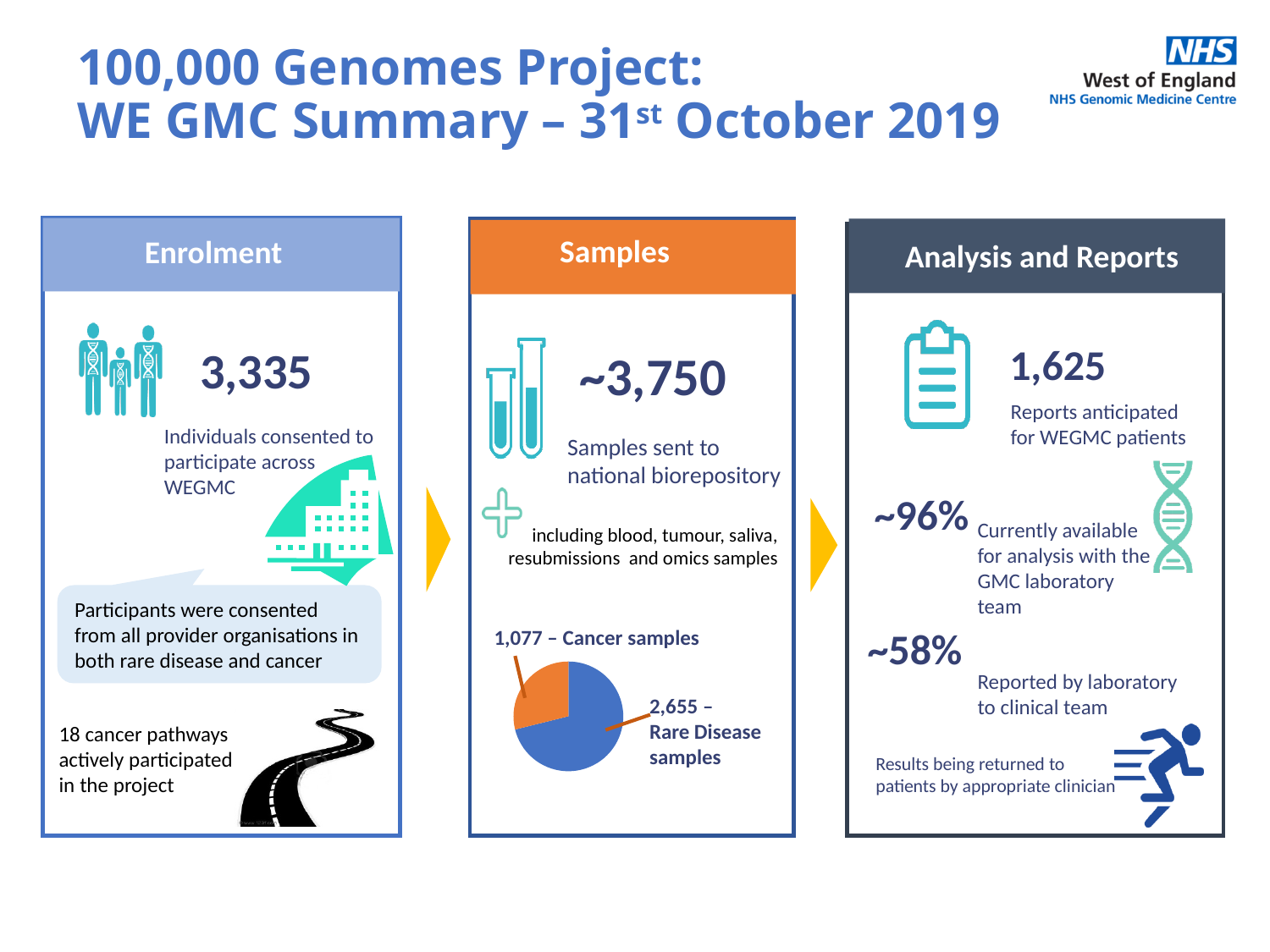
What kind of chart is shown in the Samples panel? pie chart In the pie chart, how many Cancer samples are shown? 1,077 Which category has the largest slice in the pie chart? Rare Disease samples How many slices does the pie chart have? 2 What colour is the Cancer samples slice in the pie chart? orange What is the total number of samples represented by the two slices of the pie chart? 3,732 What is the difference between the number of Rare Disease samples and Cancer samples in the pie chart? 1,578 What colour is the Rare Disease samples slice in the pie chart? blue In the pie chart, how many Rare Disease samples are shown? 2,655 Which category has the smallest slice in the pie chart? Cancer samples Which slice of the pie chart is larger, Cancer samples or Rare Disease samples? Rare Disease samples What share of the pie chart do Cancer samples represent, to the nearest whole percent? 29%